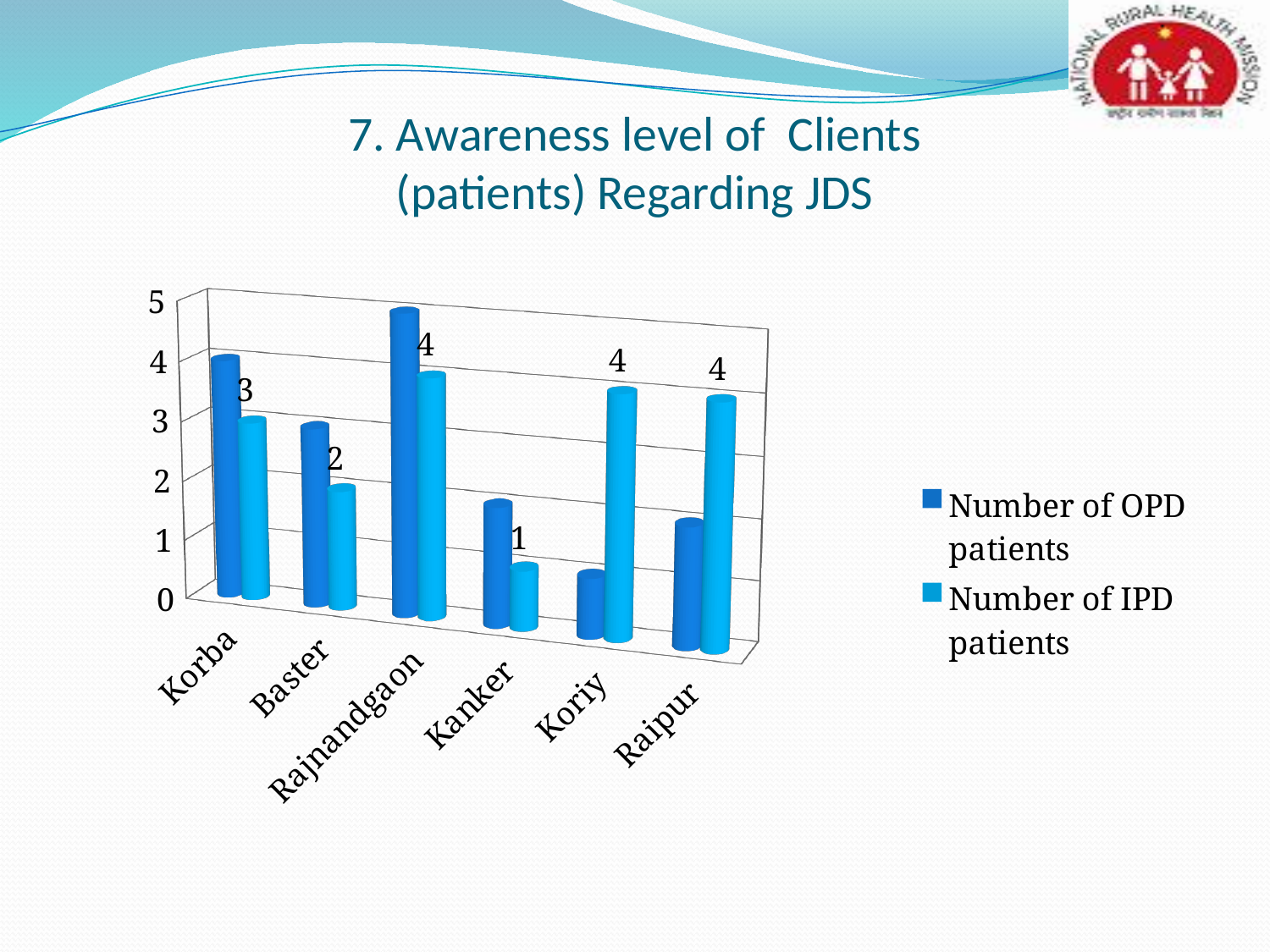
Which district has the lowest Number of IPD patients? Kanker How many series does the chart's legend list? 2 What is the difference between the Number of IPD patients for Korba and for Baster? 1 Is the Number of OPD patients for Korba greater or less than 3? greater How many districts are shown on the x axis of the chart? 6 Which is larger, the Number of IPD patients for Rajnandgaon or for Kanker? Rajnandgaon What is the Number of IPD patients for Baster? 2 What is the Number of IPD patients for Raipur? 4 What is the Number of IPD patients for Korba? 3 What kind of chart is shown on the slide? Bar chart What is the Number of IPD patients for Kanker? 1